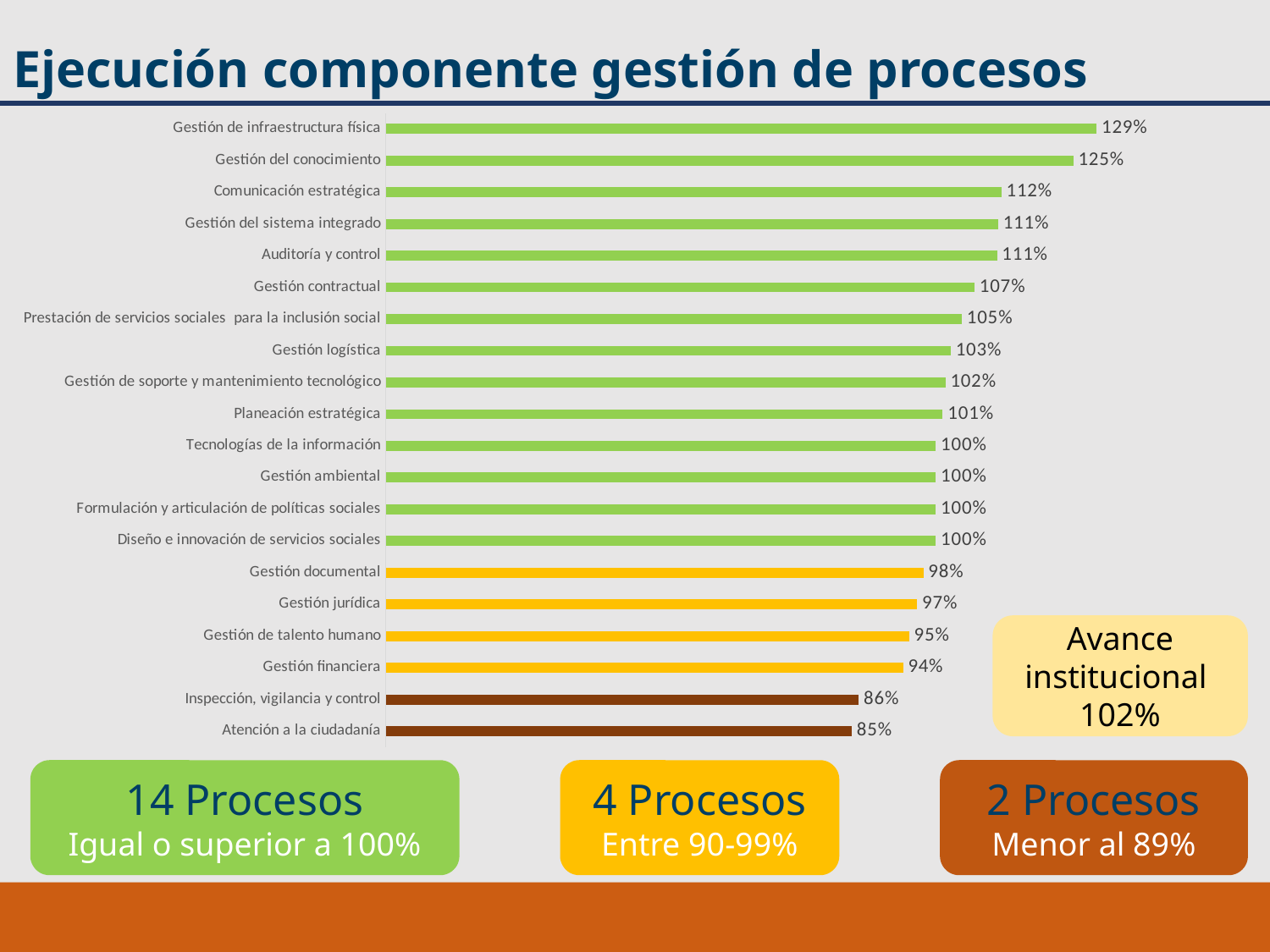
What is the difference between the values for Gestión de infraestructura física and Atención a la ciudadanía? 44% What is the value for Gestión de infraestructura física? 129% What is the value for Gestión contractual? 107% What is the value for Gestión financiera? 94% Which category has the lowest value? Atención a la ciudadanía What is the value for Inspección, vigilancia y control? 86% Which category has the highest value? Gestión de infraestructura física What is the title of the slide containing the chart? Ejecución componente gestión de procesos What is the difference between the values for Gestión del conocimiento and Comunicación estratégica? 13% What kind of chart is shown on the slide? Bar chart Which is larger, the value for Gestión logística or the value for Gestión documental? Gestión logística How many categories are shown in the chart? 20